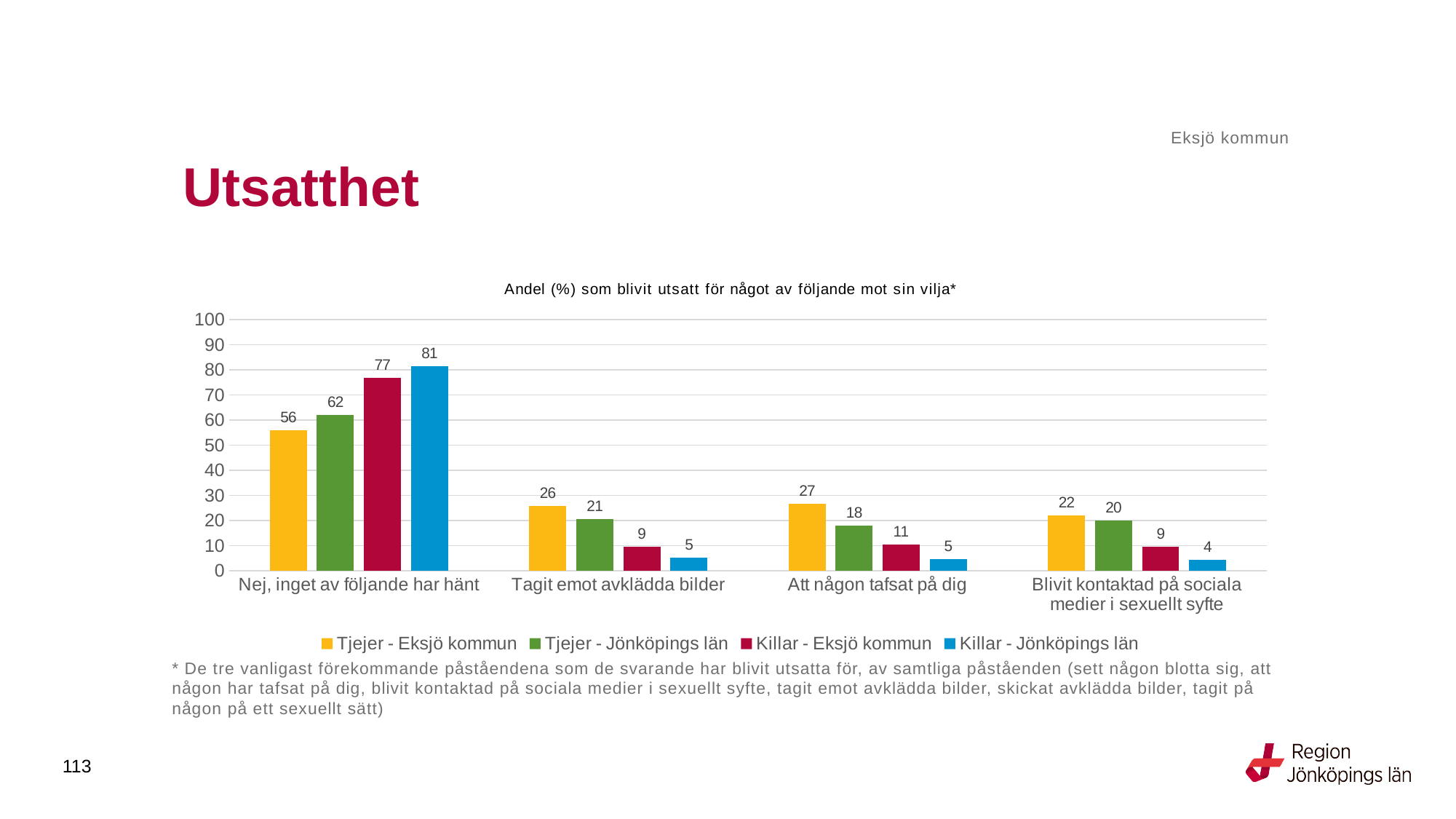
What is the value for Tjejer - Jönköpings län in the category 'Att någon tafsat på dig'? 18 What is the title of the chart? Andel (%) som blivit utsatt för något av följande mot sin vilja* What is the value for Killar - Eksjö kommun in the category 'Blivit kontaktad på sociala medier i sexuellt syfte'? 9 How many categories are shown on the x axis of the chart? 4 What is the difference between Killar - Jönköpings län and Tjejer - Eksjö kommun in the category 'Nej, inget av följande har hänt'? 25 What is the value for Killar - Jönköpings län in the category 'Tagit emot avklädda bilder'? 5 Which is larger in the category 'Tagit emot avklädda bilder': Tjejer - Eksjö kommun or Tjejer - Jönköpings län? Tjejer - Eksjö kommun What is the value for Tjejer - Eksjö kommun in the category 'Nej, inget av följande har hänt'? 56 How many series does the legend list? 4 What kind of chart is shown on the slide? Bar chart Which series has the highest value in the category 'Nej, inget av följande har hänt'? Killar - Jönköpings län Which series has the lowest value in the category 'Blivit kontaktad på sociala medier i sexuellt syfte'? Killar - Jönköpings län